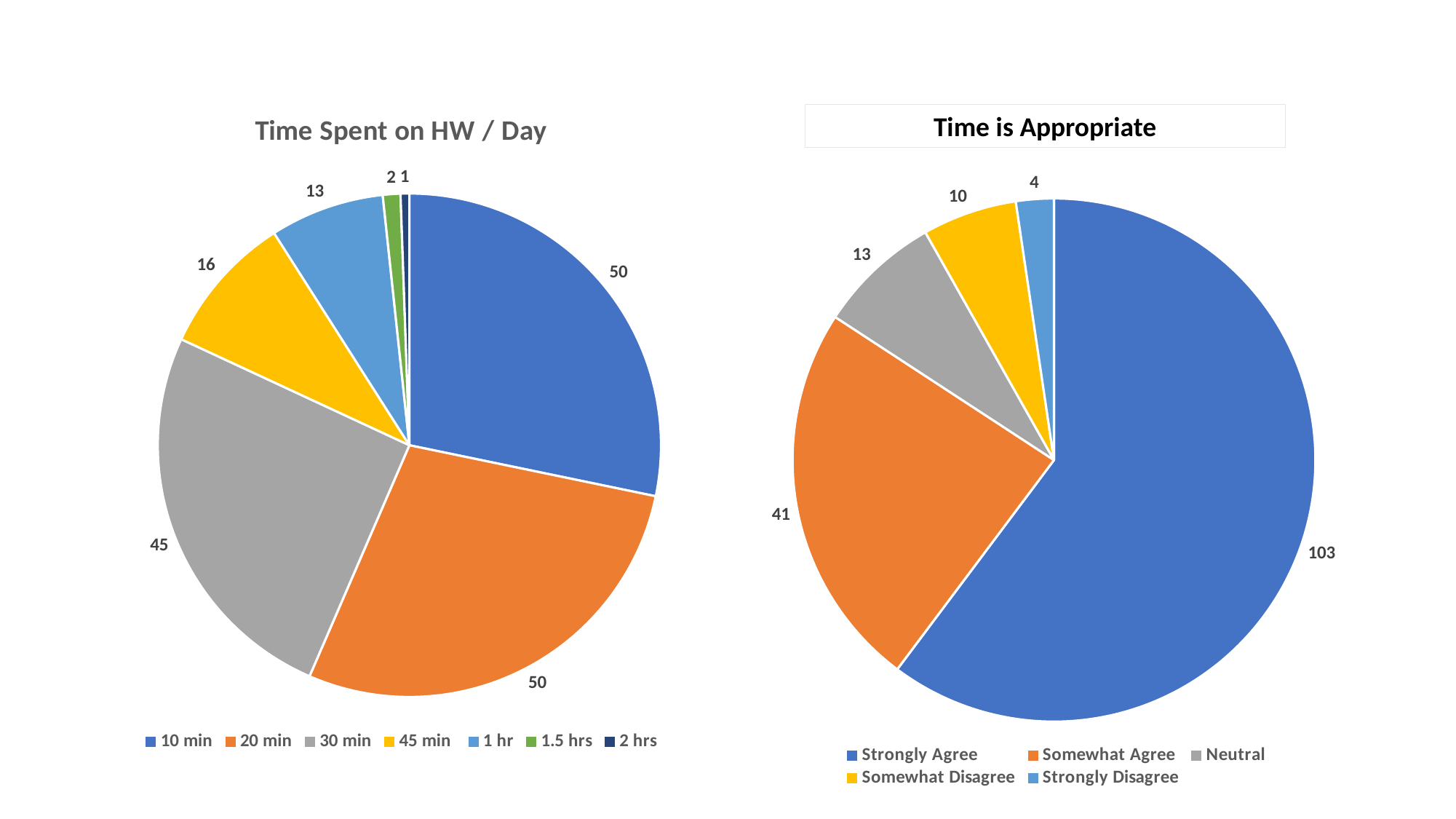
In the 'Time is Appropriate' chart, what is the total of all the slices? 171 In the 'Time is Appropriate' chart, which category has the smallest slice? Strongly Disagree In the 'Time Spent on HW / Day' chart, what is the difference between the values for 30 min and 45 min? 29 In the 'Time Spent on HW / Day' chart, how many categories does the legend list? 7 In the 'Time Spent on HW / Day' chart, which is larger, the value for 45 min or the value for 1 hr? 45 min What type of chart is the 'Time is Appropriate' chart? Pie chart In the 'Time is Appropriate' chart, which category has the largest slice? Strongly Agree In the 'Time is Appropriate' chart, what is the value for Somewhat Agree? 41 In the 'Time Spent on HW / Day' chart, which category has the smallest slice? 2 hrs In the 'Time is Appropriate' chart, what is the difference between the values for Strongly Agree and Somewhat Agree? 62 In the 'Time Spent on HW / Day' chart, what is the value for 30 min? 45 In the 'Time Spent on HW / Day' chart, what is the value for 1 hr? 13